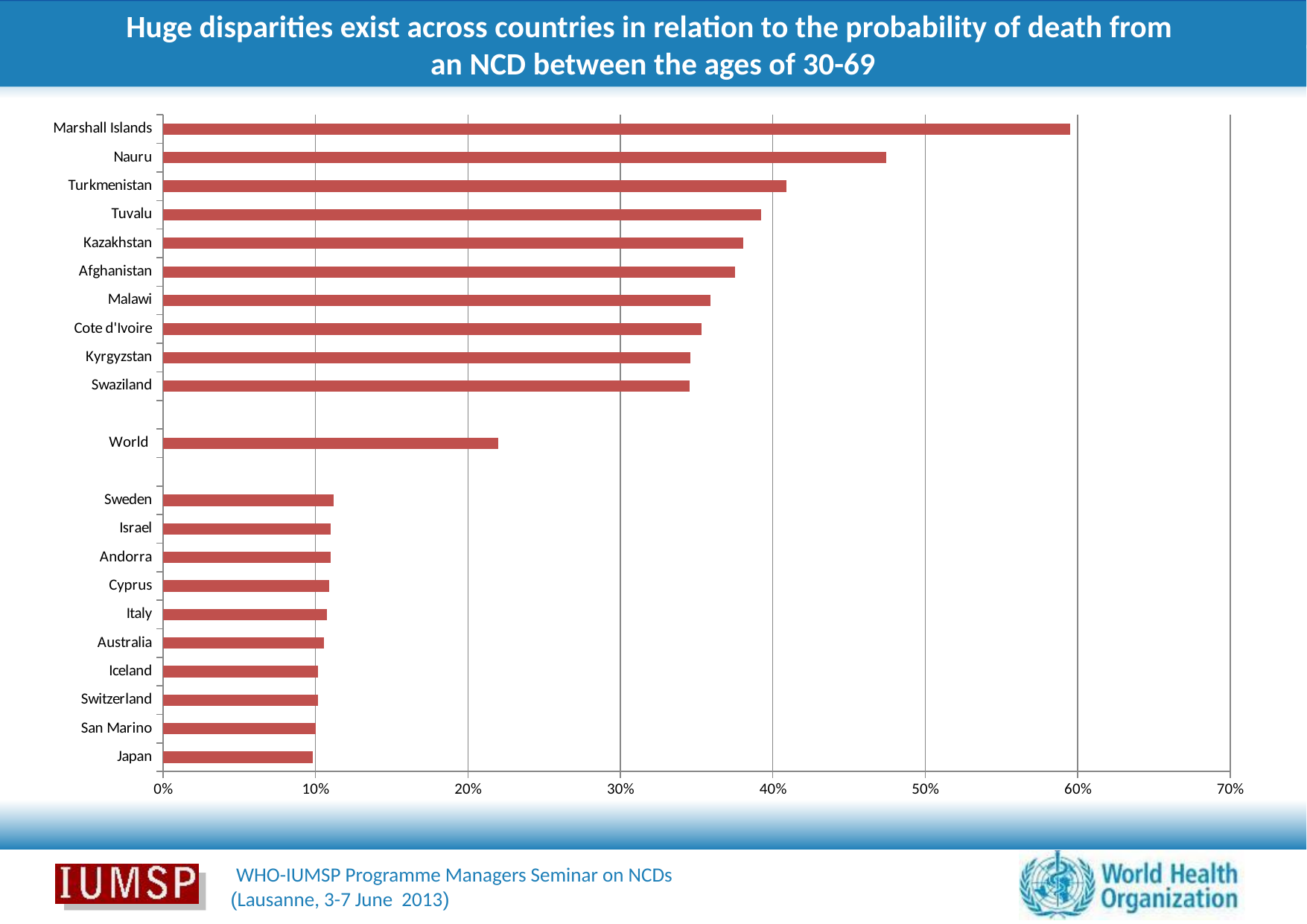
Is the value for Marshall Islands greater or less than 50%? greater Is the value for Tuvalu greater or less than 40%? less Which has the larger value, Nauru or Turkmenistan? Nauru What is the highest value shown on the x axis of the chart? 70% Is the value for Kazakhstan greater or less than 40%? less Which country has the highest probability of death from an NCD between ages 30-69 on the chart? Marshall Islands What kind of chart is shown on the slide? bar chart Which has the larger value, World or Sweden? World How many labelled bars (countries plus World) are shown on the chart? 21